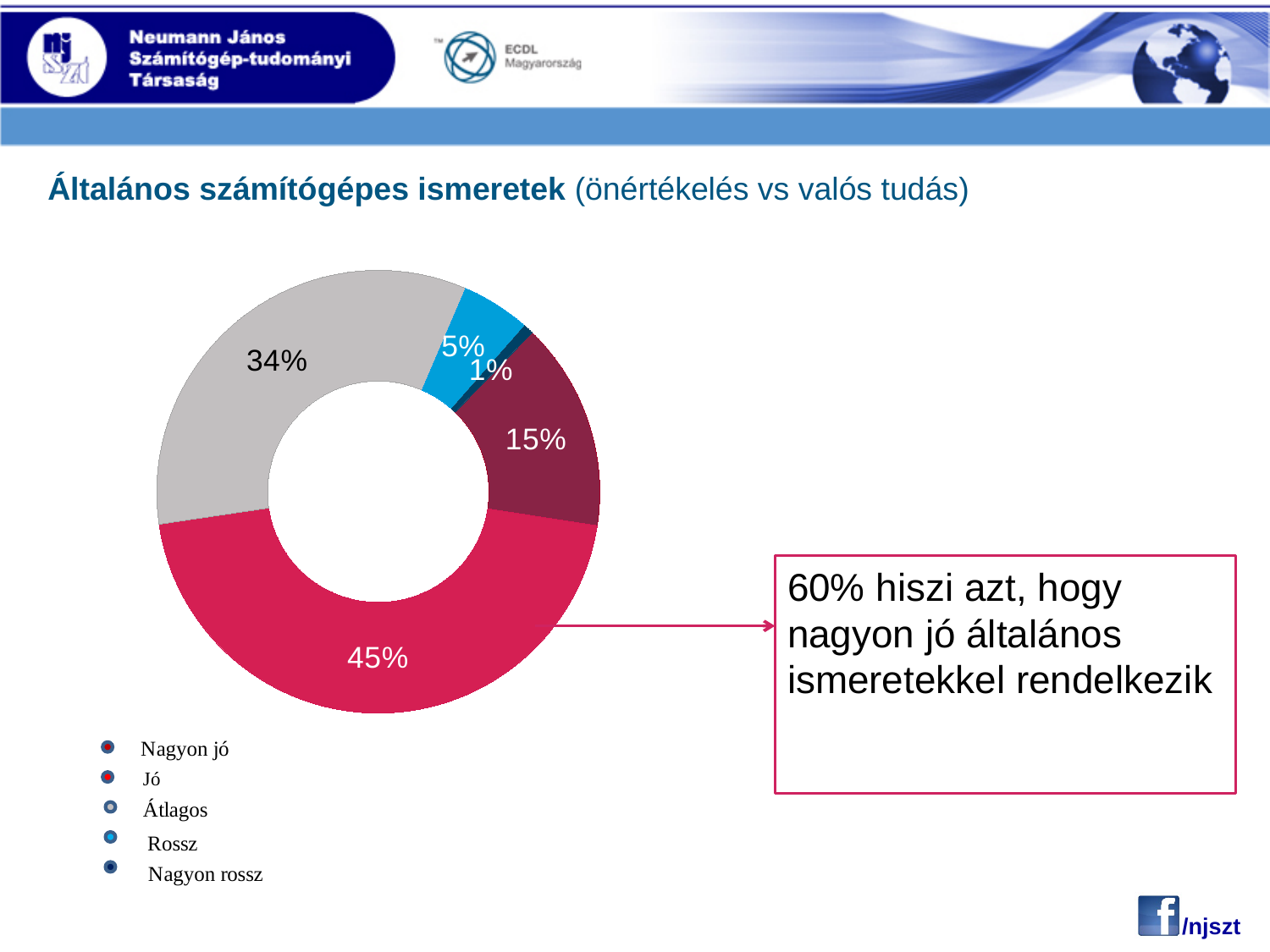
Which is larger, the grey slice or the dark red slice? The grey slice (34%) What percentage is shown on the light blue slice of the chart? 5% What is the combined share of the 45% and 15% slices? 60% What kind of chart is shown on the slide? Doughnut (pie) chart What is the smallest percentage shown on the chart? 1% What is the difference between the largest slice (45%) and the grey slice (34%)? 11 percentage points What is the largest percentage shown on the chart? 45% What percentage is shown on the grey slice of the chart? 34% What percentage is shown on the dark red (maroon) slice of the chart? 15% How many entries does the legend list? 5 How many slices does the doughnut chart have? 5 What is the first entry listed in the chart legend? Nagyon jó